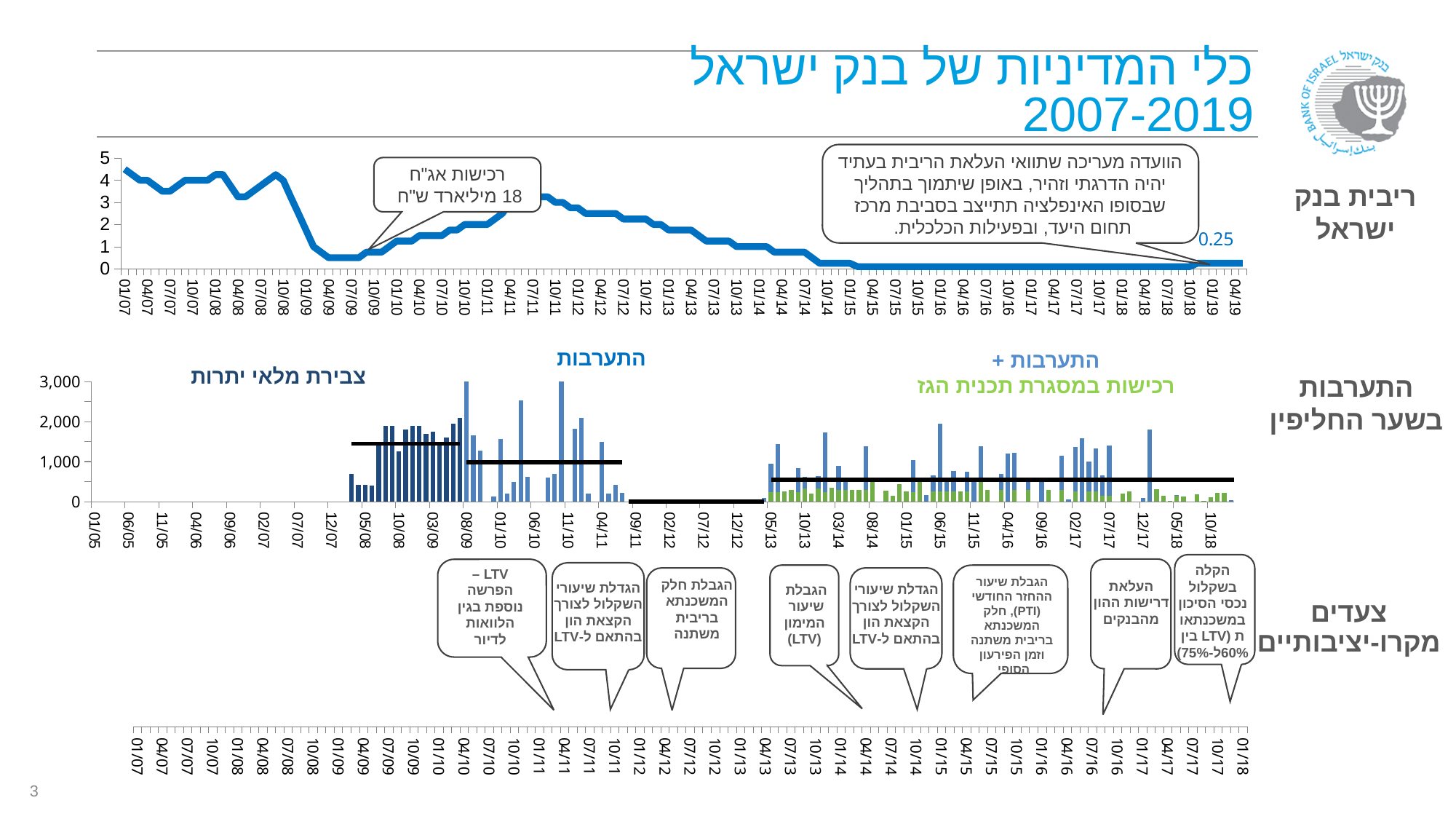
In the top interest rate chart, is the value at 10/11 greater or less than 2? greater In the top interest rate chart, which is larger, the value at 01/07 or the value at 04/19? 01/07 In the top interest rate chart, is the value at 04/09 greater or less than 1? less What kind of chart is the middle chart showing foreign exchange interventions? bar chart In the middle bar chart of foreign exchange interventions, is the tallest bar greater or less than 2,000? greater What kind of chart is the top chart showing the Bank of Israel interest rate? line chart In the top interest rate chart, what value is printed as a data label at the right end of the line? 0.25 In the middle bar chart of foreign exchange interventions, what is the highest value shown on the y axis? 3,000 In the top interest rate chart, does the line rise or fall between 07/09 and 10/11? rises In the top interest rate chart, does the line overall rise or fall from 01/07 to 04/19? falls